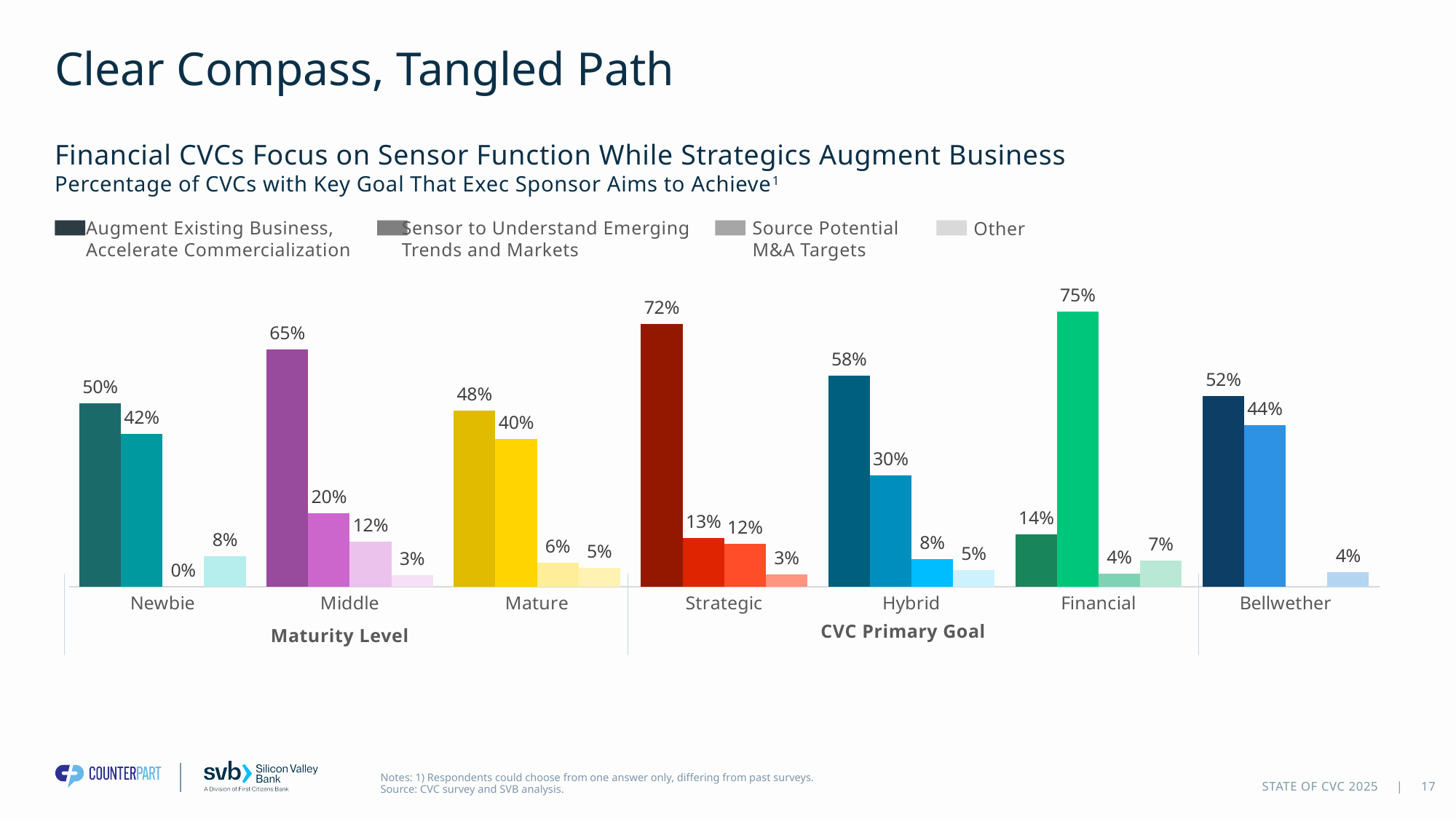
What is the value for 'Source Potential M&A Targets' in the Newbie category? 0% What is the difference between the 'Augment Existing Business' value and the 'Sensor to Understand Emerging Trends and Markets' value for Hybrid CVCs? 28% Which category has the lowest value for 'Augment Existing Business, Accelerate Commercialization'? Financial What is the value for 'Other' in the Middle category? 3% Which is larger for Mature CVCs: 'Augment Existing Business, Accelerate Commercialization' or 'Sensor to Understand Emerging Trends and Markets'? Augment Existing Business, Accelerate Commercialization How many series does the legend list? 4 What percentage of Strategic CVCs have 'Augment Existing Business, Accelerate Commercialization' as their key goal? 72% What kind of chart is shown on the slide? Bar chart Which category has the highest value for 'Augment Existing Business, Accelerate Commercialization'? Strategic What percentage of Financial CVCs have 'Sensor to Understand Emerging Trends and Markets' as their key goal? 75% How many categories are shown along the x axis of the chart? 7 What are the two group labels shown beneath the x axis categories? Maturity Level and CVC Primary Goal